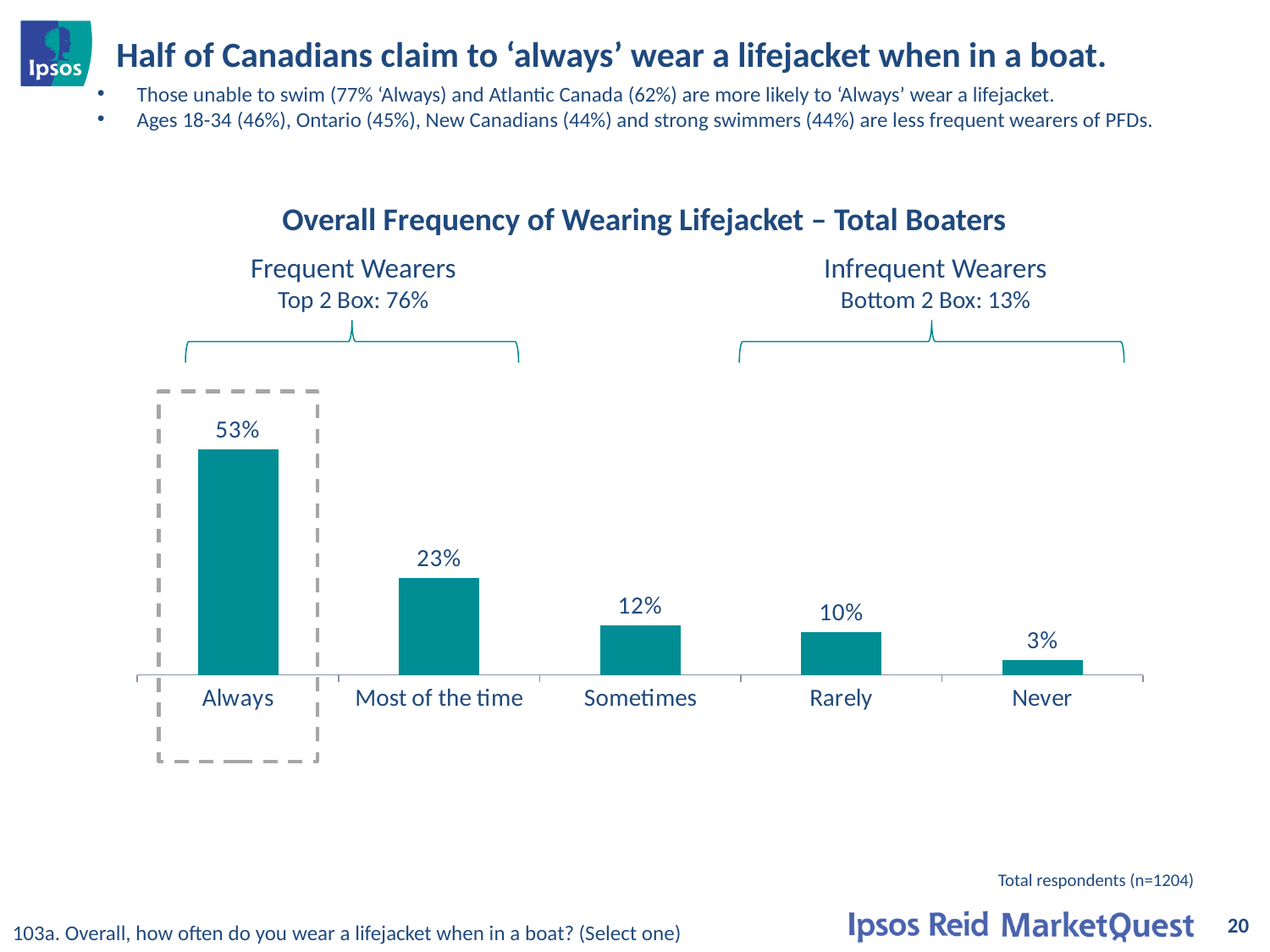
What percentage of boaters say they 'Always' wear a lifejacket? 53% Do the values rise or fall from left to right along the x axis? Fall What percentage of boaters 'Never' wear a lifejacket? 3% What is the value for 'Rarely'? 10% Which category has the highest value? Always Which category has the lowest value? Never What kind of chart is shown on the slide? Bar chart What is the title of the chart? Overall Frequency of Wearing Lifejacket – Total Boaters Which is larger, the value for 'Sometimes' or the value for 'Rarely'? Sometimes What is the difference between the 'Always' and 'Most of the time' values? 30% How many categories are shown on the x axis? 5 What is the value for 'Most of the time'? 23%